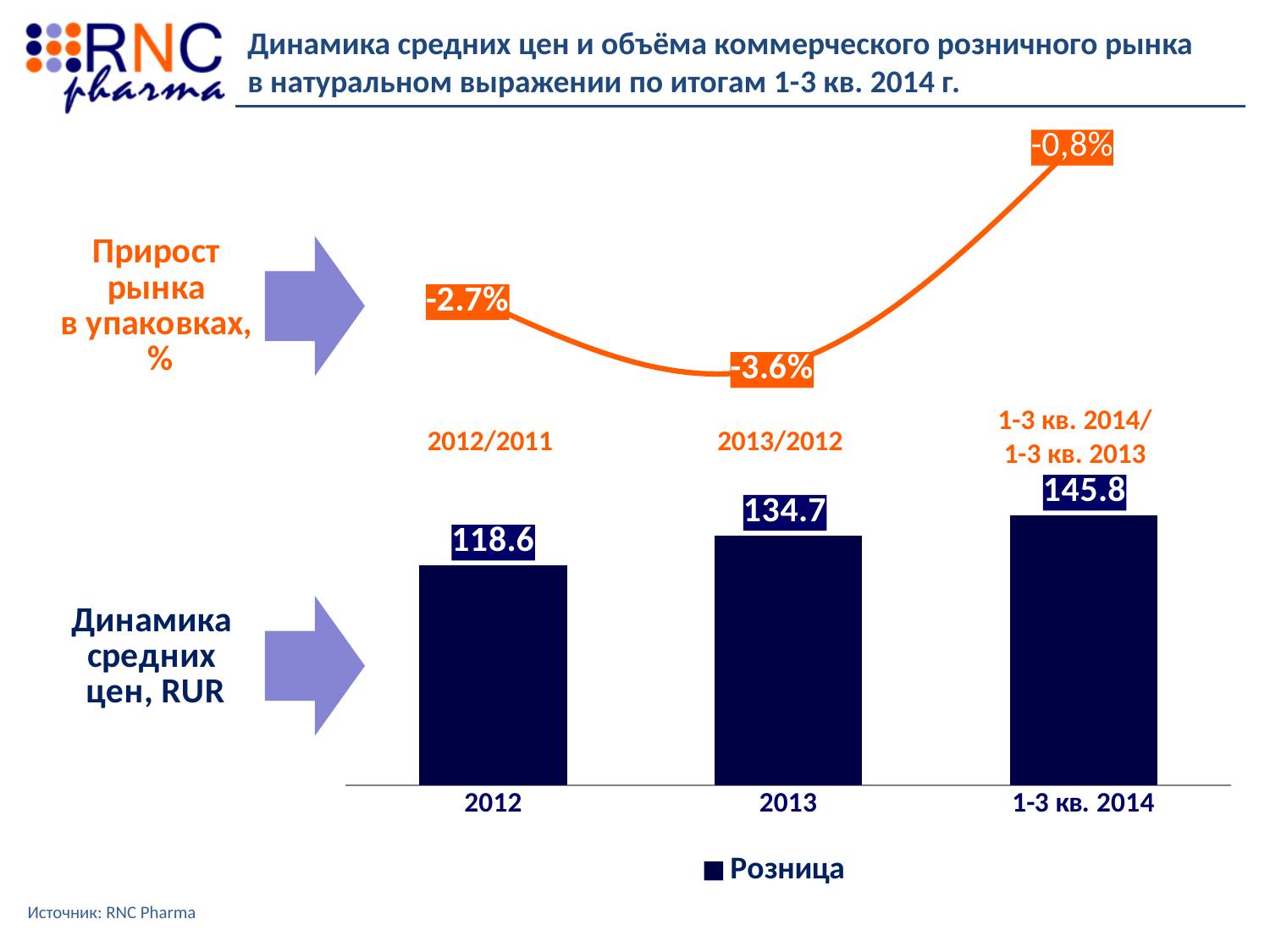
In the bottom bar chart (Динамика средних цен, RUR), what is the value for 1-3 кв. 2014? 145.8 How many data points are plotted in the top line chart (Прирост рынка в упаковках, %)? 3 In the bottom bar chart (Динамика средних цен, RUR), which category has the lowest value? 2012 What kind of chart is the bottom chart (Динамика средних цен, RUR)? bar chart What series name does the legend of the bottom bar chart list? Розница In the top line chart (Прирост рынка в упаковках, %), which period has the lowest value? 2013/2012 In the top line chart (Прирост рынка в упаковках, %), what is the value for 2013/2012? -3.6% In the bottom bar chart (Динамика средних цен, RUR), what is the value for 2013? 134.7 In the top line chart (Прирост рынка в упаковках, %), what is the value for 2012/2011? -2.7% In the bottom bar chart (Динамика средних цен, RUR), which category has the highest value? 1-3 кв. 2014 In the bottom bar chart (Динамика средних цен, RUR), do the values rise or fall from 2012 to 1-3 кв. 2014? rise In the bottom bar chart (Динамика средних цен, RUR), what is the difference between the values for 2013 and 2012? 16.1